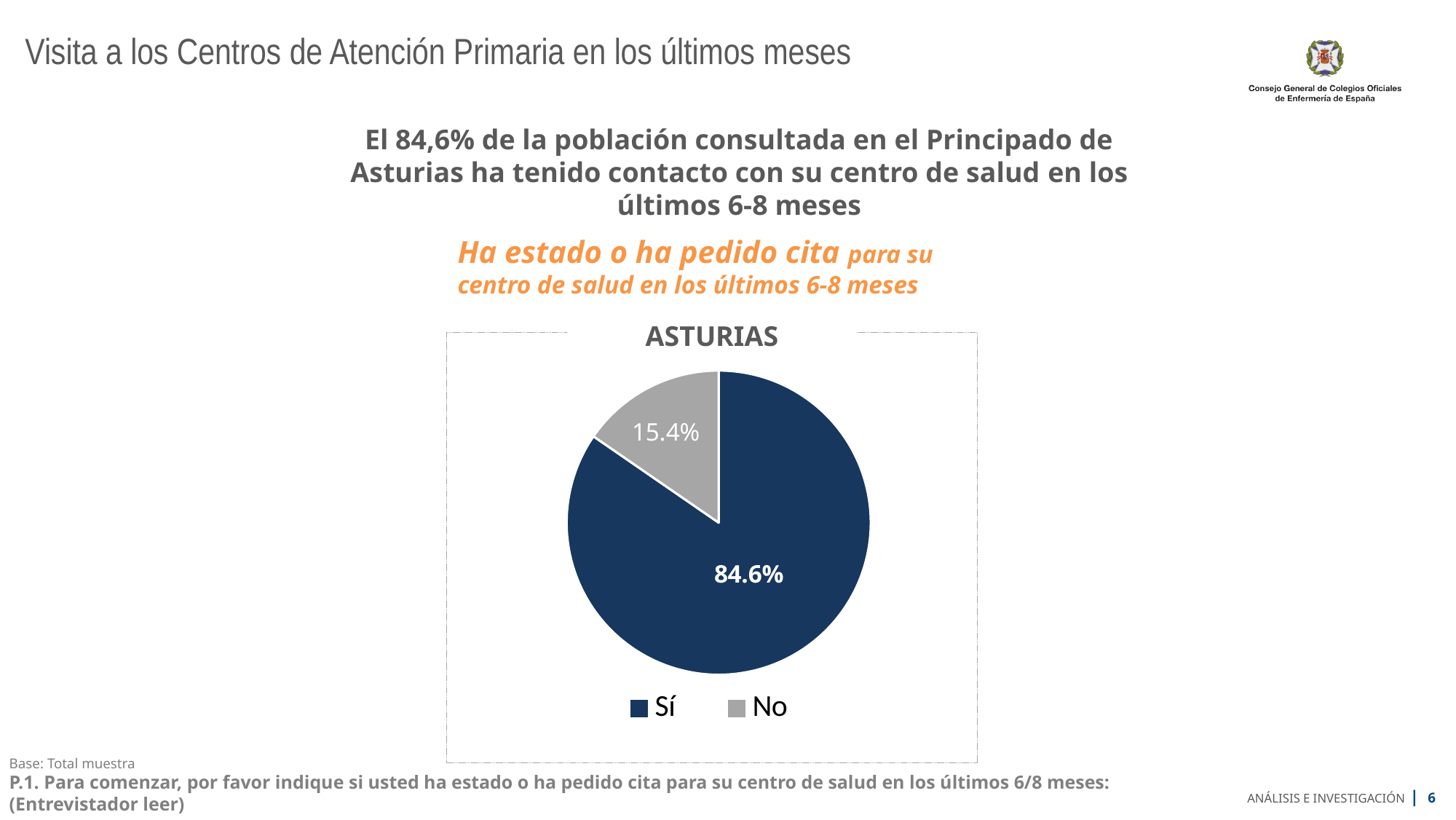
Which is larger in the pie chart, "Sí" or "No"? Sí What percentage of the pie chart is labelled "No"? 15.4% What colour is the "No" slice in the pie chart? Grey What is the title of the pie chart? ASTURIAS What percentage of the pie chart is labelled "Sí"? 84.6% How many entries does the chart legend list? 2 Which slice of the pie chart is the smallest? No How many slices does the pie chart have? 2 What is the difference in percentage points between the "Sí" and "No" slices? 69.2 What share of the pie does the "No" slice represent? 15.4% Which slice of the pie chart is the largest? Sí What type of chart is shown on the slide? Pie chart